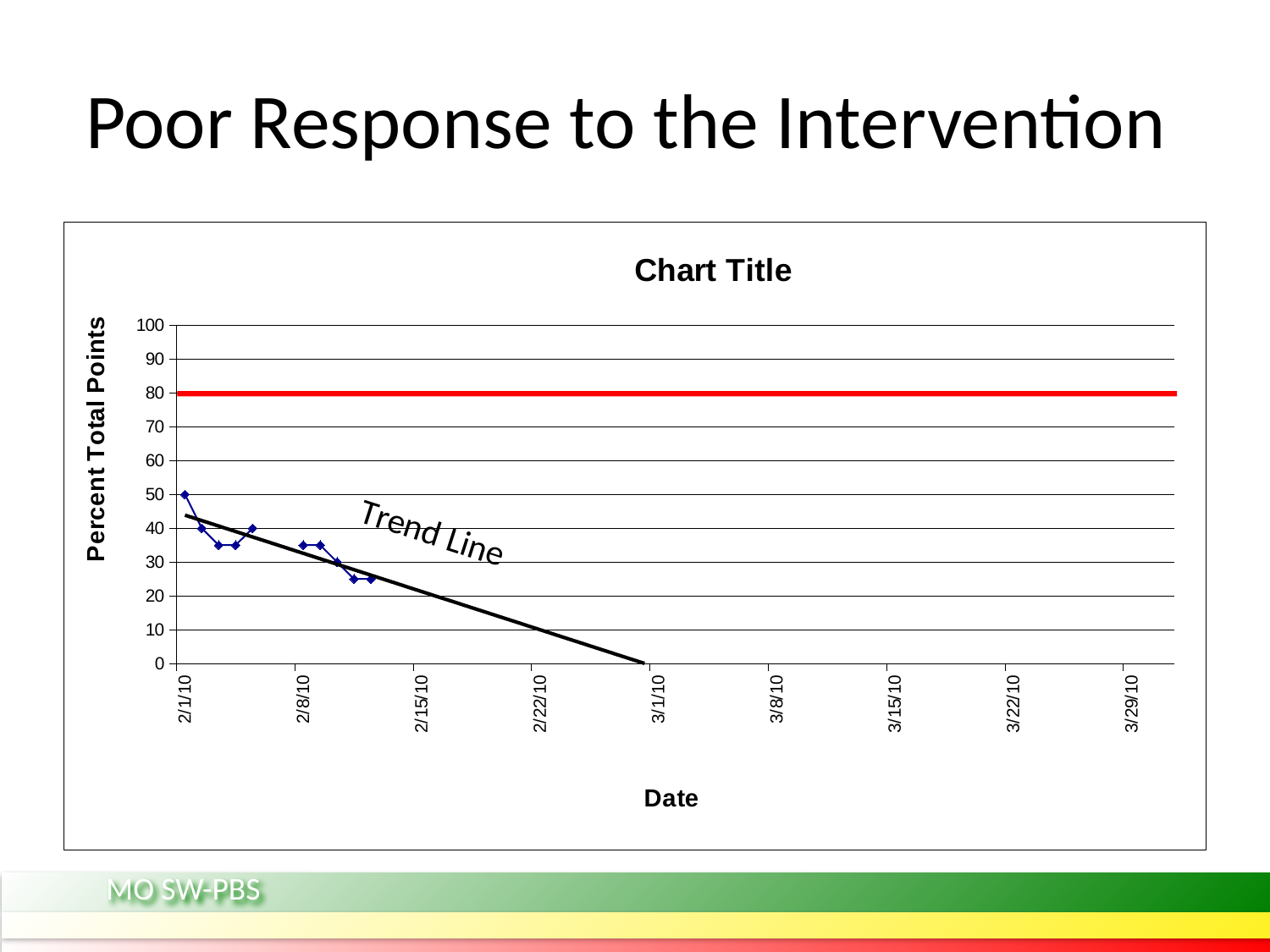
What is the label of the horizontal axis? Date Are the last plotted data points greater or less than 30? less Which date has the highest plotted value? 2/1/10 What is the value of the first data point, on 2/1/10? 50 Is the first data point (2/1/10) larger or smaller than the last data point? larger What is the label of the vertical axis? Percent Total Points What is the title printed above the chart? Chart Title What kind of chart is shown on the slide? line chart What value does the horizontal red line sit at on the vertical axis? 80 Do the plotted values generally rise or fall over time along the x axis? fall Is the value of the first data point on 2/1/10 greater or less than 40? greater Are any of the plotted data points greater or less than the red line at 80? less